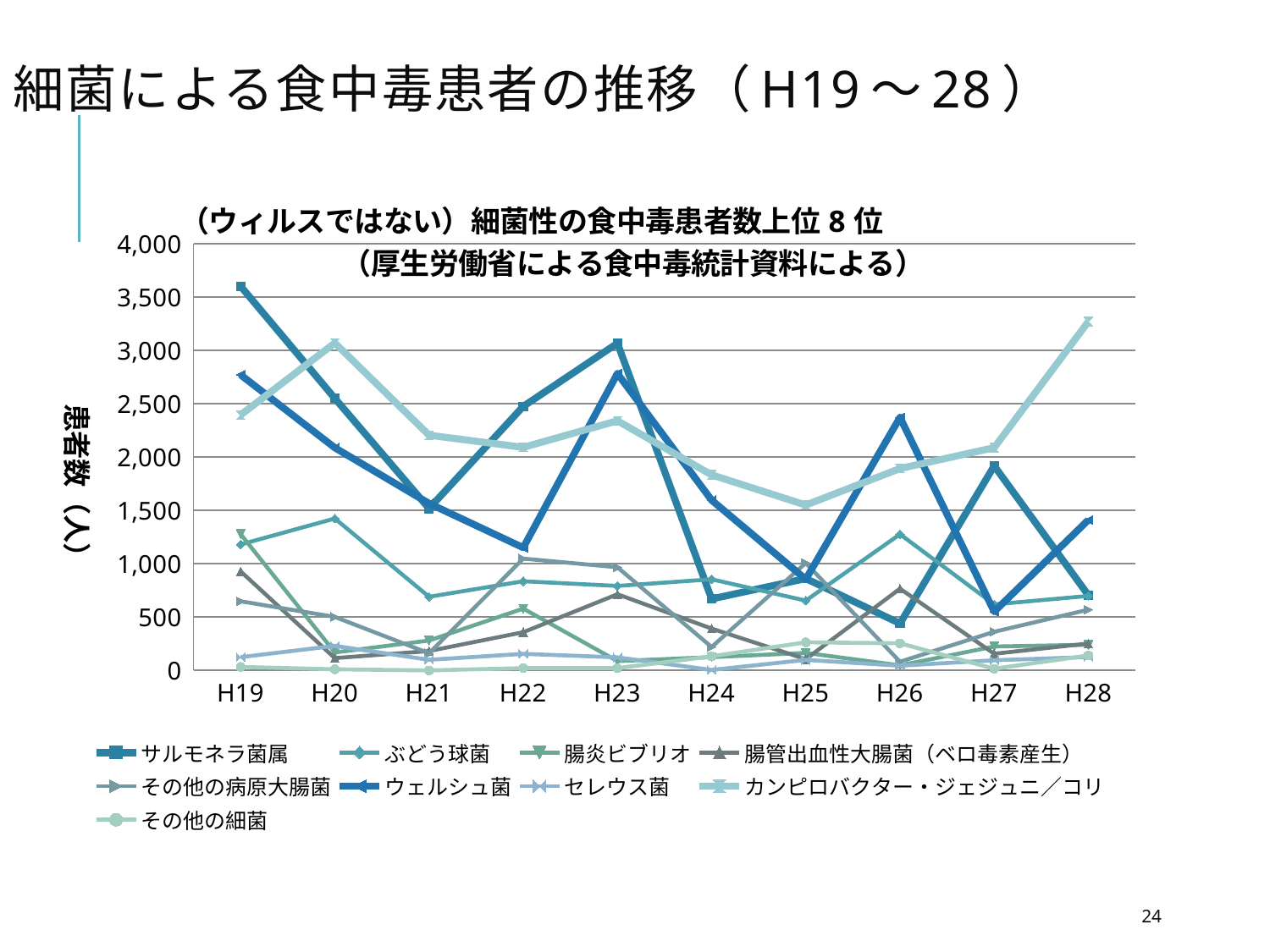
Is the value for サルモネラ菌属 at H26 greater or less than 1,000? less Which series has the highest value at H28? カンピロバクター・ジェジュニ／コリ How many series does the legend list? 9 What kind of chart is shown on the slide? line chart Does the value for カンピロバクター・ジェジュニ／コリ rise or fall from H25 to H28? rise How many years (points) are shown along the x axis? 10 Which series has the highest value at H20? カンピロバクター・ジェジュニ／コリ Is the value for カンピロバクター・ジェジュニ／コリ at H28 greater or less than 3,000? greater Which series has the highest value at H19? サルモネラ菌属 At H23, which is larger: サルモネラ菌属 or ウェルシュ菌? サルモネラ菌属 Is the value for サルモネラ菌属 at H19 greater or less than 3,000? greater What is the label on the y axis? 患者数（人）